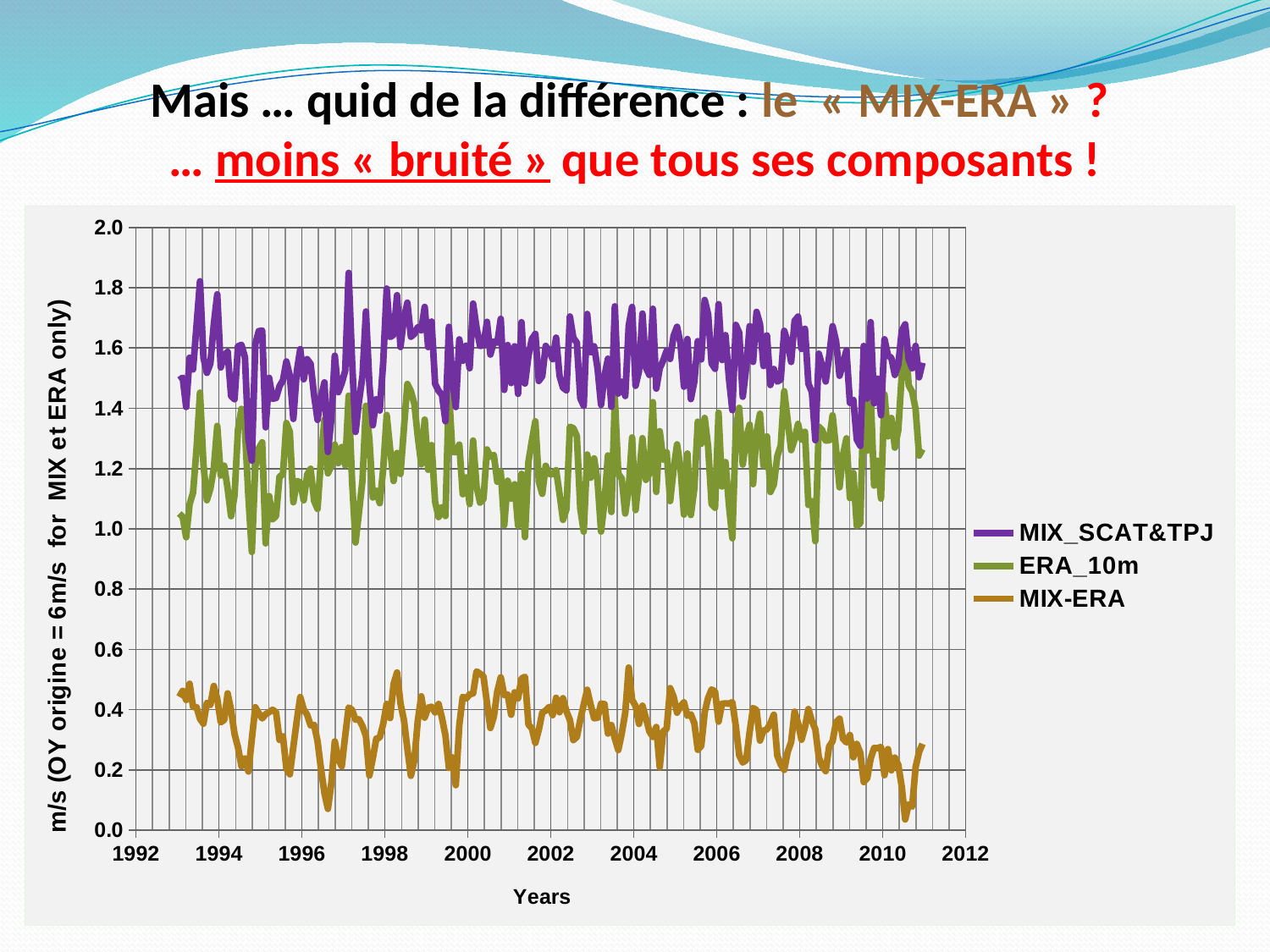
What is the label of the x axis? Years Which series has the highest values across the whole period? MIX_SCAT&TPJ What kind of chart is shown on the slide? line chart How many series does the legend list? 3 Which series has the lowest values across the whole period? MIX-ERA What is the highest value shown on the y axis? 2.0 Are the values of the MIX-ERA series greater or less than 0.6 throughout the period? less Are the values of the MIX_SCAT&TPJ series greater or less than 1.0 throughout the period? greater Which series is plotted in green? ERA_10m Which series has larger values, MIX_SCAT&TPJ or ERA_10m? MIX_SCAT&TPJ